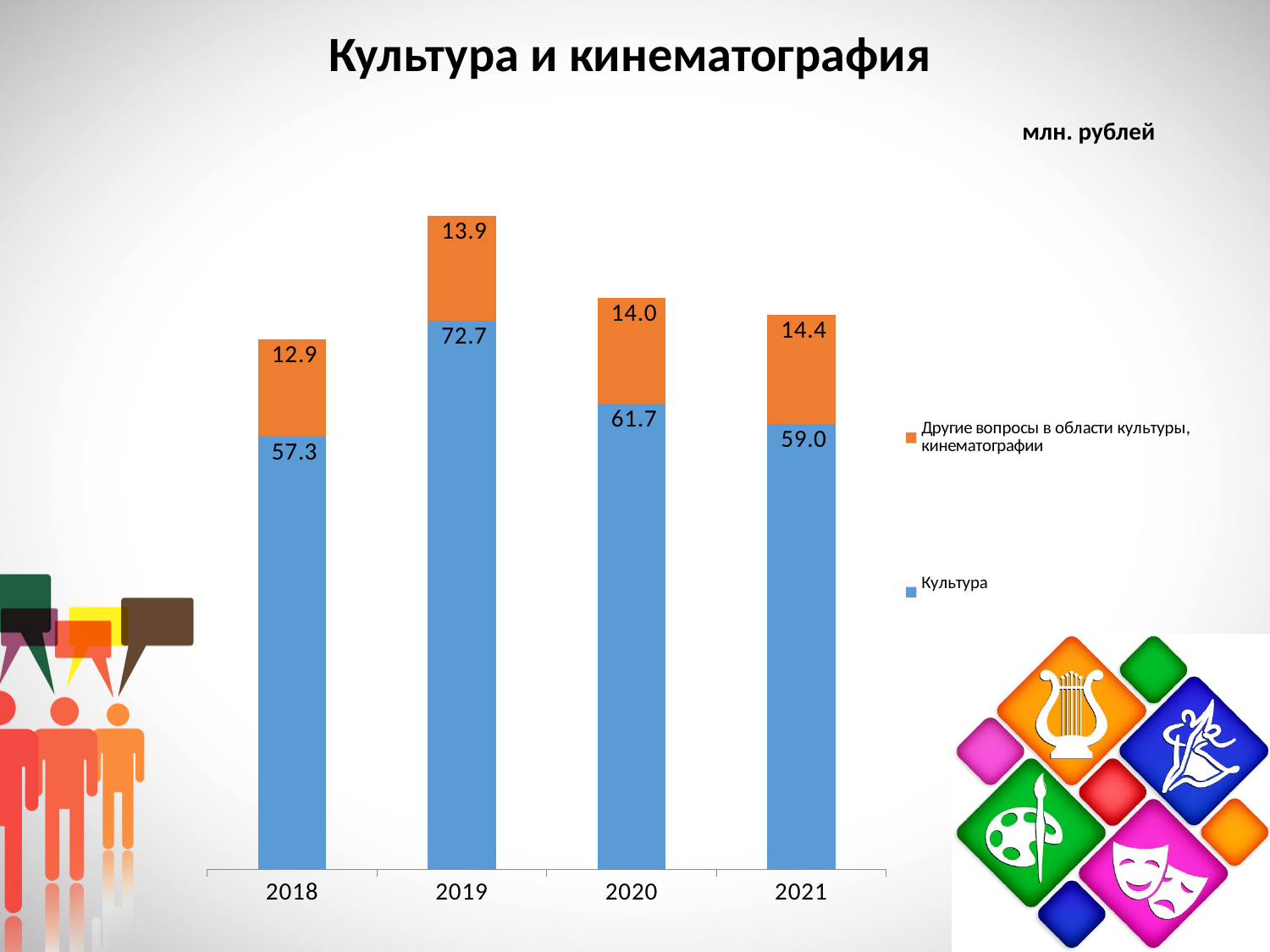
How many series does the legend list? 2 What is the value for Культура in 2018? 57.3 What is the value for Другие вопросы в области культуры, кинематографии in 2021? 14.4 What is the difference between the Культура values for 2019 and 2018? 15.4 How many years are shown on the x axis? 4 What is the value for Культура in 2019? 72.7 In which year is the value for Культура the highest? 2019 Which is larger: the Культура value for 2020 or for 2021? 2020 In which year is the value for Другие вопросы в области культуры, кинематографии the lowest? 2018 What kind of chart is shown on the slide? Stacked bar chart What is the total of the stacked bar for 2019? 86.6 What is the total of the stacked bar for 2018? 70.2